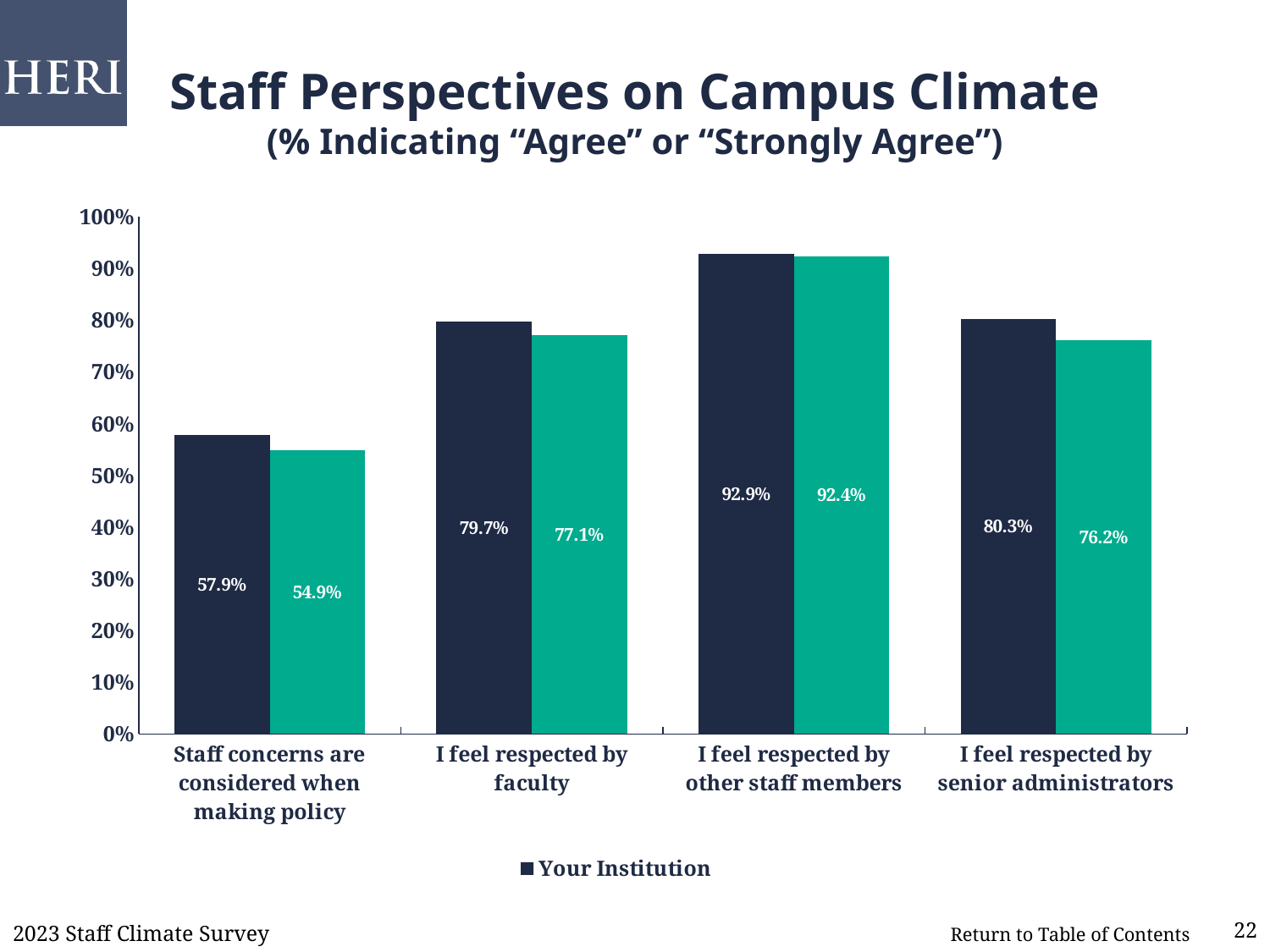
What kind of chart is shown on the slide? Bar chart What value does the teal bar show for "Staff concerns are considered when making policy"? 54.9% Which is larger for Your Institution: the value for "I feel respected by faculty" or for "I feel respected by senior administrators"? I feel respected by senior administrators For "I feel respected by senior administrators", what is the difference between the Your Institution value and the teal bar's value? 4.1 percentage points For "I feel respected by faculty", how much higher is the Your Institution value than the teal bar's value? 2.6 percentage points What is the Your Institution value for "I feel respected by faculty"? 79.7% Is the Your Institution value for "I feel respected by other staff members" greater or less than 90%? greater Which category has the highest Your Institution value? I feel respected by other staff members How many series does the legend list? 1 Which category has the lowest Your Institution value? Staff concerns are considered when making policy How many categories are shown on the x axis? 4 What is the Your Institution value for "I feel respected by senior administrators"? 80.3%